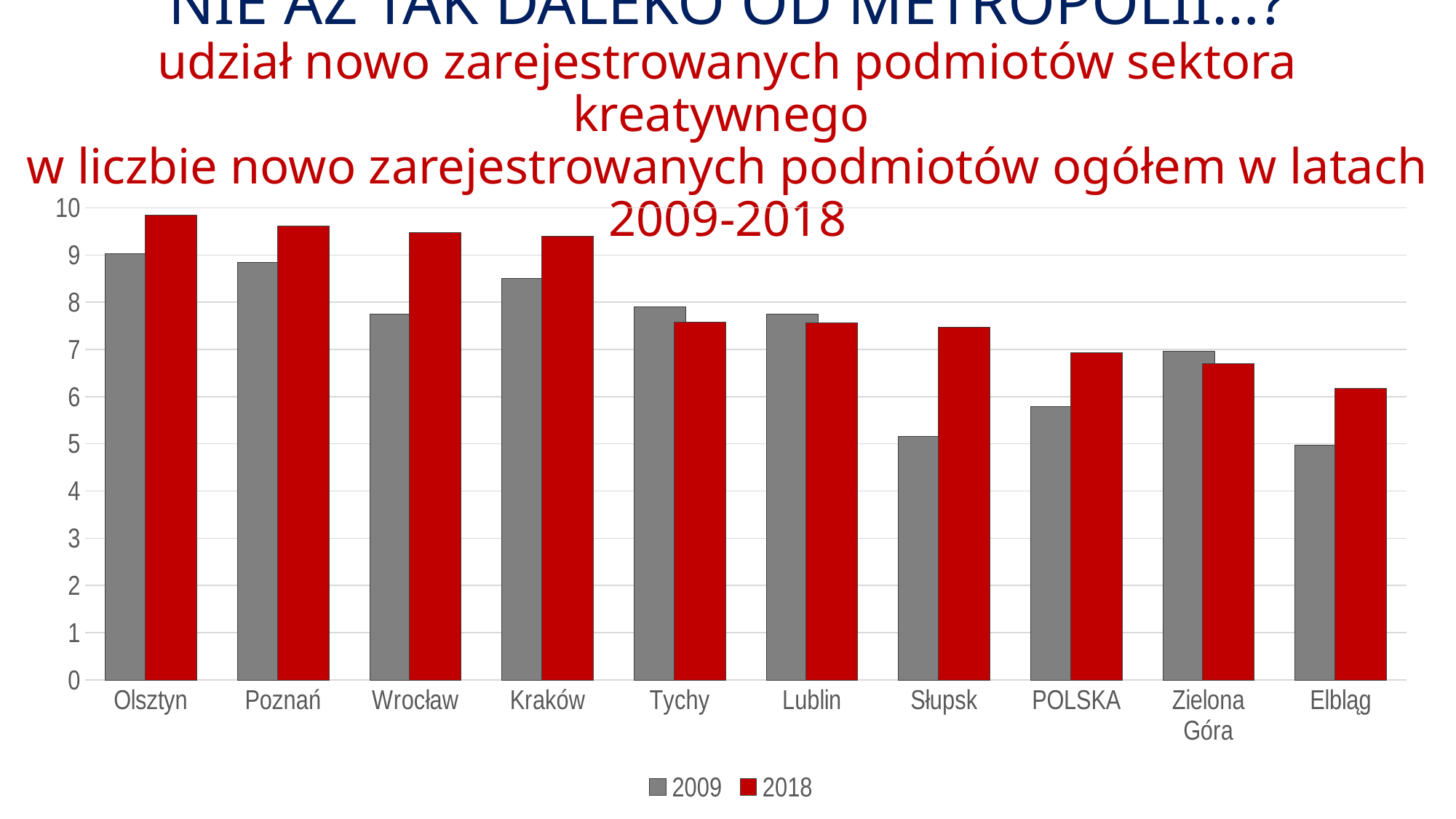
Which category has the lowest value for 2018? Elbląg How many series does the legend list? 2 Which category has the highest value for 2009? Olsztyn What kind of chart is shown on the slide? bar chart Is the 2018 value for Wrocław greater or less than 9? greater What colour are the bars for the 2018 series? red How many categories are shown on the x axis of the chart? 10 For Słupsk, which is larger: the 2009 value or the 2018 value? 2018 Is the 2009 value for POLSKA greater or less than 6? less Is the 2009 value for Elbląg greater or less than 6? less Which category has the highest value for 2018? Olsztyn For Tychy, which is larger: the 2009 value or the 2018 value? 2009